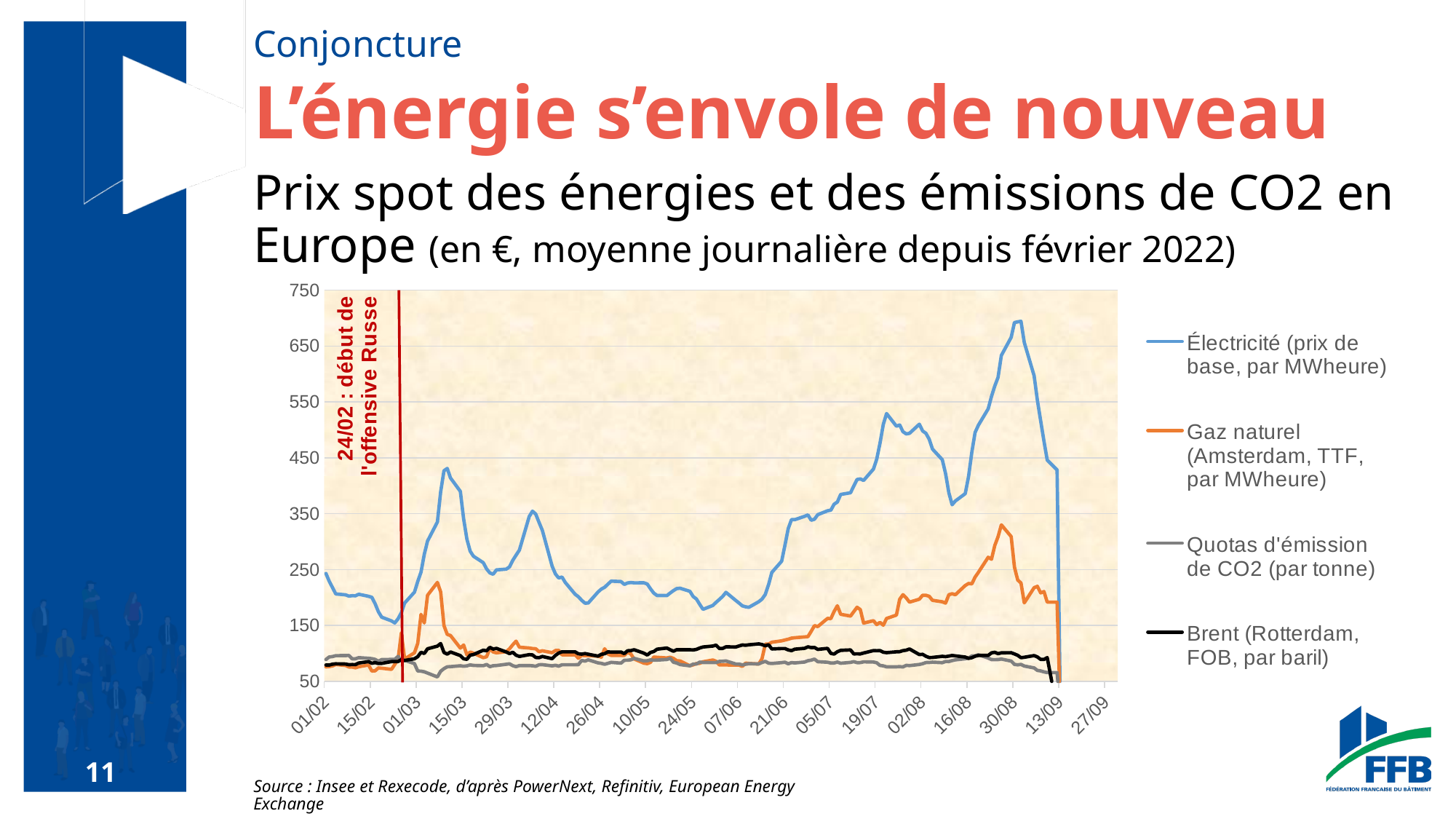
Does the Électricité series rise or fall between 16/08 and 30/08? Rise Is the Quotas d'émission de CO2 series greater or less than 150 throughout the period? less Around 30/08, which series is higher: Électricité or Gaz naturel? Électricité What event does the red vertical line on the chart mark? 24/02 : début de l'offensive Russe Is the peak value of the Gaz naturel series greater or less than 250? greater What type of chart is shown on the slide? Line chart How many series does the legend list? 4 Is the peak value of the Électricité series greater or less than 650? greater Which series reaches the highest value on the chart? Électricité (prix de base, par MWheure) What is the title of the chart? Prix spot des énergies et des émissions de CO2 en Europe (en €, moyenne journalière depuis février 2022)